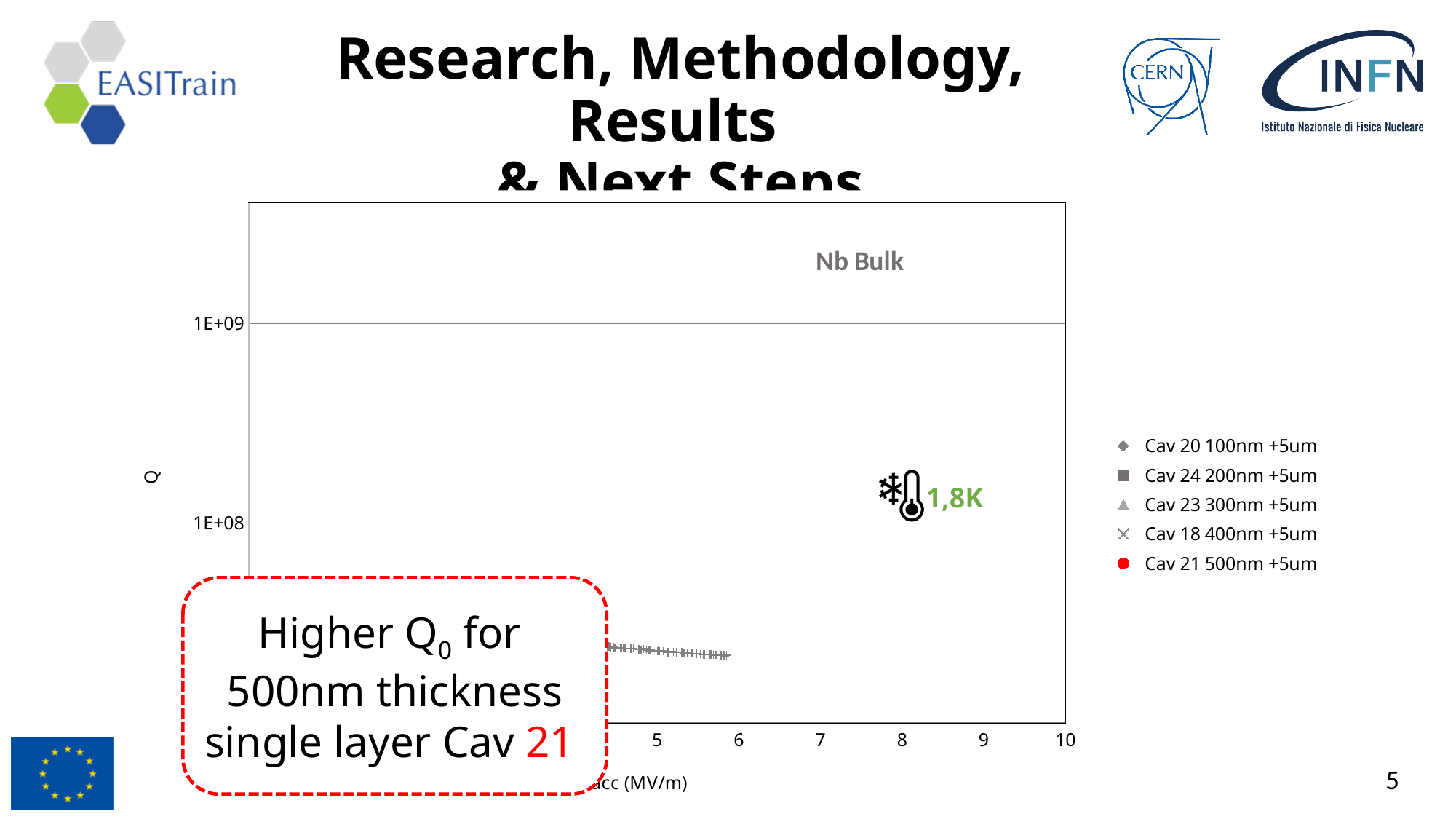
What kind of chart is shown on the slide? scatter chart Do the plotted Q values for Cav 18 400nm +5um rise or fall as Eacc increases from about 4.5 to 6 MV/m? fall Which series in the legend is marked with a red circle? Cav 21 500nm +5um How many series does the chart legend list? 5 Is the Q value for Cav 18 400nm +5um at around 5 MV/m greater or less than 1E+08? less